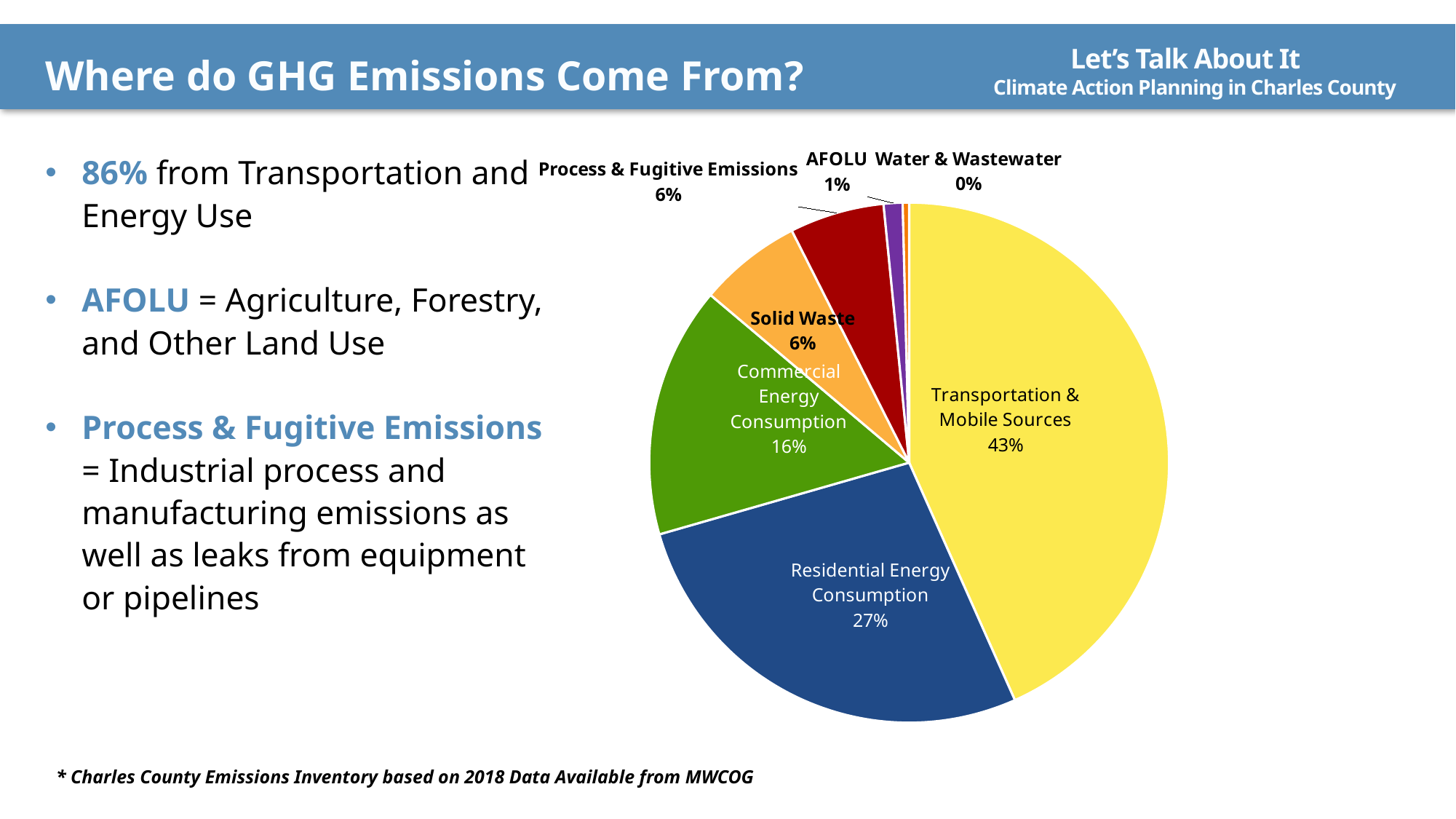
Which has a larger share, Commercial Energy Consumption or Solid Waste? Commercial Energy Consumption What is the difference between the shares for Transportation & Mobile Sources and Residential Energy Consumption? 16% How many categories are shown in the pie chart? 7 Which category has the largest share of emissions? Transportation & Mobile Sources What share of emissions comes from Residential Energy Consumption? 27% What share of emissions comes from Water & Wastewater? 0% What share of emissions comes from Transportation & Mobile Sources? 43% What kind of chart is shown on the slide? Pie chart Which category has the smallest share of emissions? Water & Wastewater